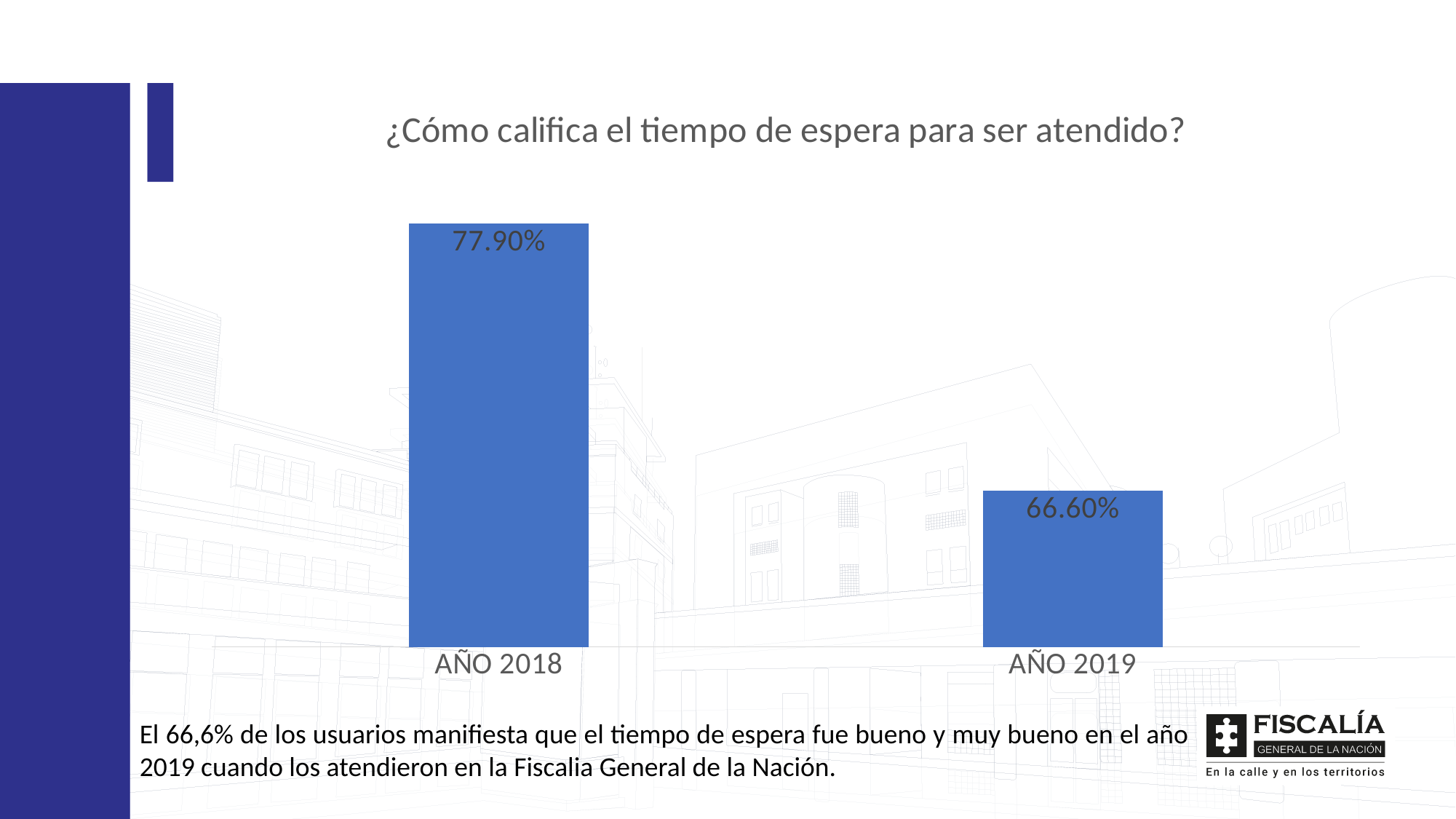
What is the title of the chart? ¿Cómo califica el tiempo de espera para ser atendido? Which category has the highest value? AÑO 2018 How many categories are shown in the chart? 2 What kind of chart is shown on the slide? Bar chart What is the value for AÑO 2019? 66.60% Do the values rise or fall from AÑO 2018 to AÑO 2019? Fall Which category has the lowest value? AÑO 2019 What is the difference between the values for AÑO 2018 and AÑO 2019? 11.30% Which is larger, the value for AÑO 2018 or AÑO 2019? AÑO 2018 What is the value for AÑO 2018? 77.90% What colour are the bars in the chart? Blue